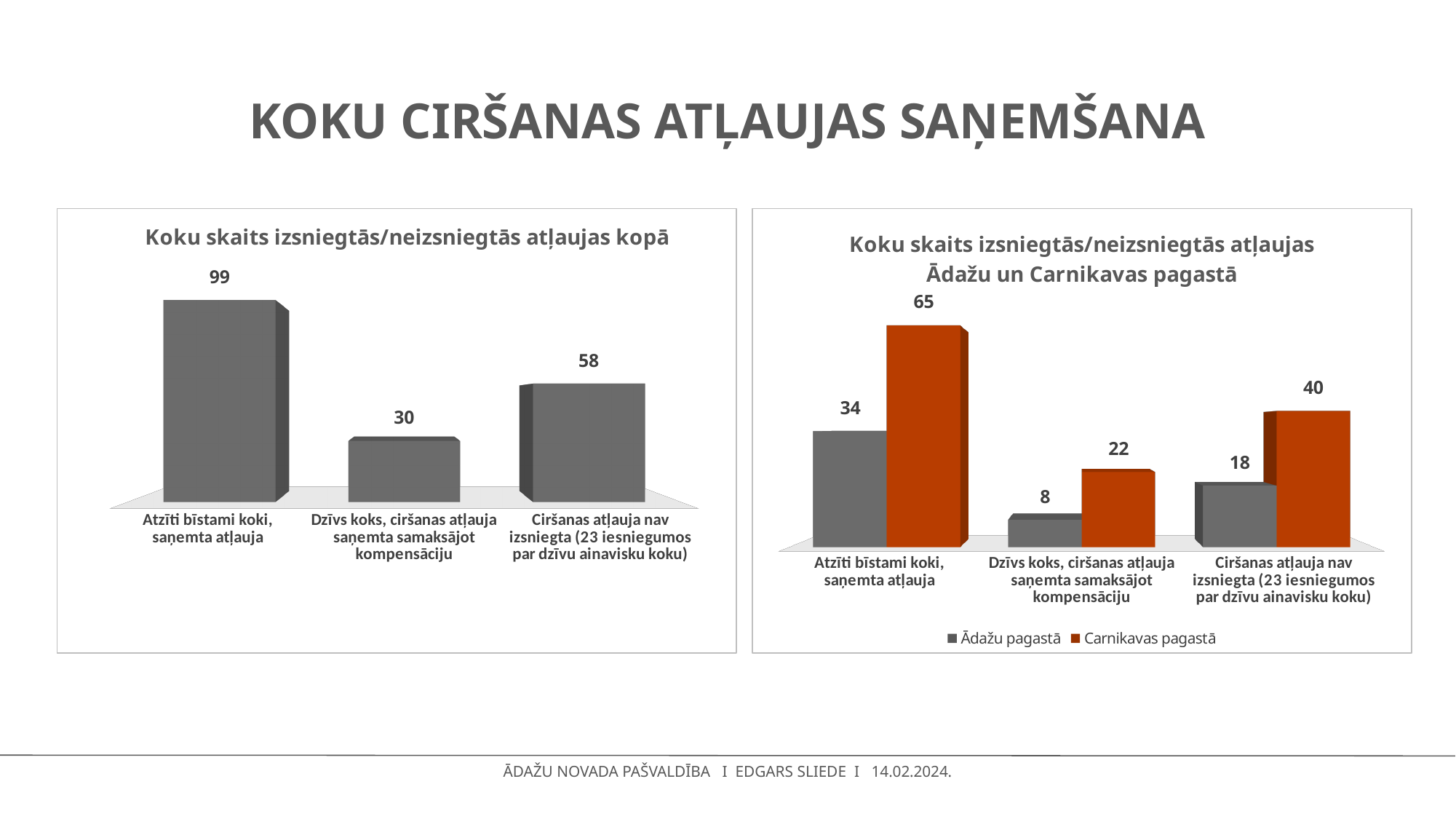
In the left chart 'Koku skaits izsniegtās/neizsniegtās atļaujas kopā', what is the difference between the values for 'Atzīti bīstami koki, saņemta atļauja' and 'Ciršanas atļauja nav izsniegta'? 41 In the left chart 'Koku skaits izsniegtās/neizsniegtās atļaujas kopā', how many categories are shown? 3 In the left chart 'Koku skaits izsniegtās/neizsniegtās atļaujas kopā', what is the value for 'Atzīti bīstami koki, saņemta atļauja'? 99 In the right chart 'Koku skaits izsniegtās/neizsniegtās atļaujas Ādažu un Carnikavas pagastā', what is the value for 'Ādažu pagastā' in the category 'Dzīvs koks, ciršanas atļauja saņemta samaksājot kompensāciju'? 8 What kind of chart is the left chart 'Koku skaits izsniegtās/neizsniegtās atļaujas kopā'? Bar chart In the right chart 'Koku skaits izsniegtās/neizsniegtās atļaujas Ādažu un Carnikavas pagastā', which is larger for 'Ciršanas atļauja nav izsniegta': 'Ādažu pagastā' or 'Carnikavas pagastā'? Carnikavas pagastā In the right chart 'Koku skaits izsniegtās/neizsniegtās atļaujas Ādažu un Carnikavas pagastā', what colour are the bars for 'Carnikavas pagastā'? Orange-red In the right chart 'Koku skaits izsniegtās/neizsniegtās atļaujas Ādažu un Carnikavas pagastā', what is the value for 'Carnikavas pagastā' in the category 'Atzīti bīstami koki, saņemta atļauja'? 65 In the right chart 'Koku skaits izsniegtās/neizsniegtās atļaujas Ādažu un Carnikavas pagastā', which series has the highest value overall? Carnikavas pagastā In the right chart 'Koku skaits izsniegtās/neizsniegtās atļaujas Ādažu un Carnikavas pagastā', how many series does the legend list? 2 In the left chart 'Koku skaits izsniegtās/neizsniegtās atļaujas kopā', which category has the lowest value? Dzīvs koks, ciršanas atļauja saņemta samaksājot kompensāciju In the right chart 'Koku skaits izsniegtās/neizsniegtās atļaujas Ādažu un Carnikavas pagastā', what is the difference between 'Carnikavas pagastā' and 'Ādažu pagastā' for 'Ciršanas atļauja nav izsniegta'? 22